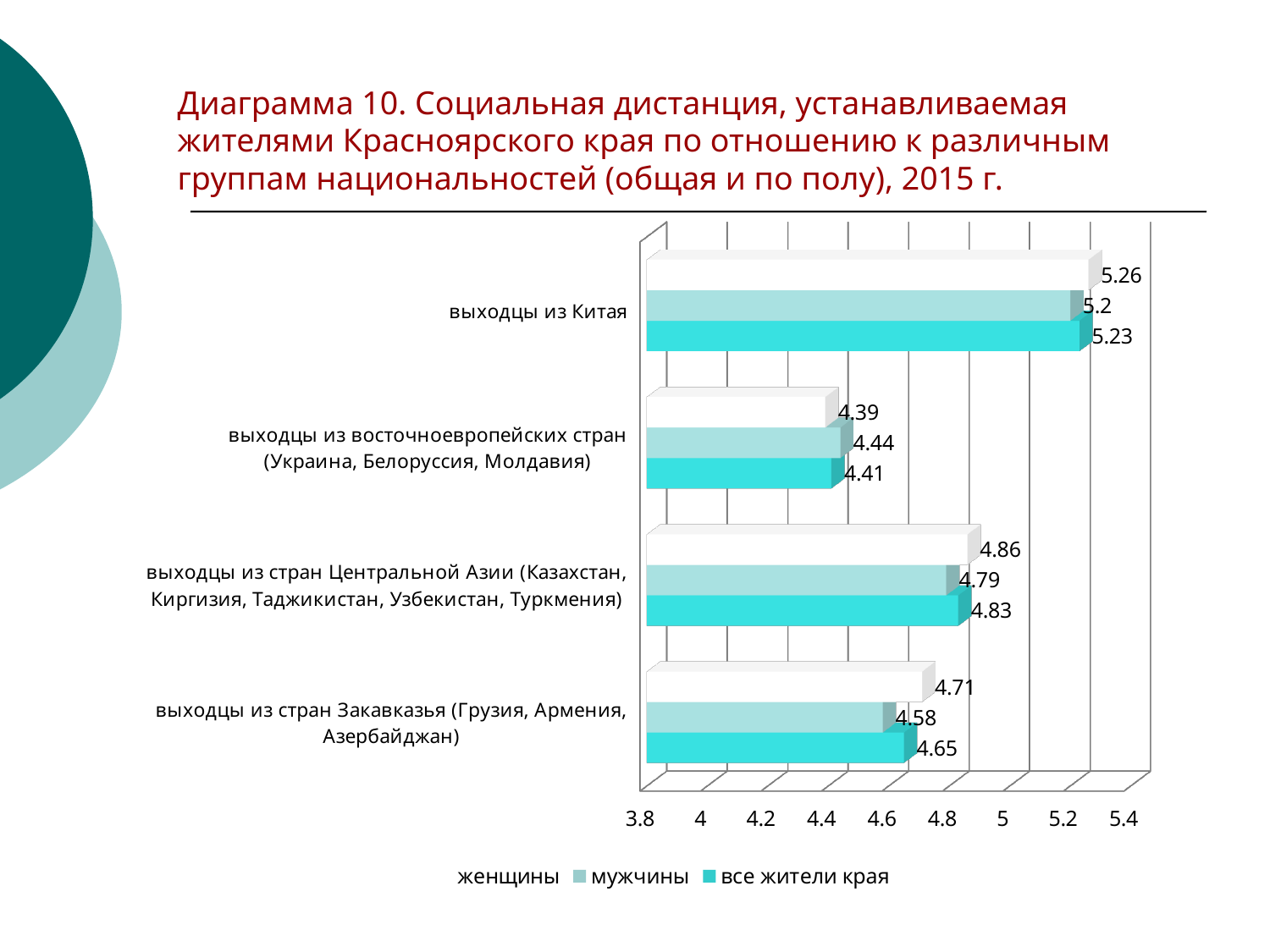
Is the value for "все жители края" for "выходцы из стран Центральной Азии" greater or less than 4.6? greater What is the value for "все жители края" for "выходцы из Китая"? 5.23 What is the difference between the "женщины" and "мужчины" values for "выходцы из стран Закавказья"? 0.13 What kind of chart is shown on the slide? bar chart Which category has the highest value for "все жители края"? выходцы из Китая How many series does the legend list? 3 For "выходцы из восточноевропейских стран", which is larger: the value for "женщины" or for "мужчины"? мужчины Which category has the lowest value for "женщины"? выходцы из восточноевропейских стран (Украина, Белоруссия, Молдавия) What is the value for "мужчины" for "выходцы из стран Центральной Азии"? 4.79 Which series is shown in white bars according to the legend? женщины What is the value for "женщины" for "выходцы из стран Закавказья (Грузия, Армения, Азербайджан)"? 4.71 How many categories of nationality groups are shown on the chart? 4